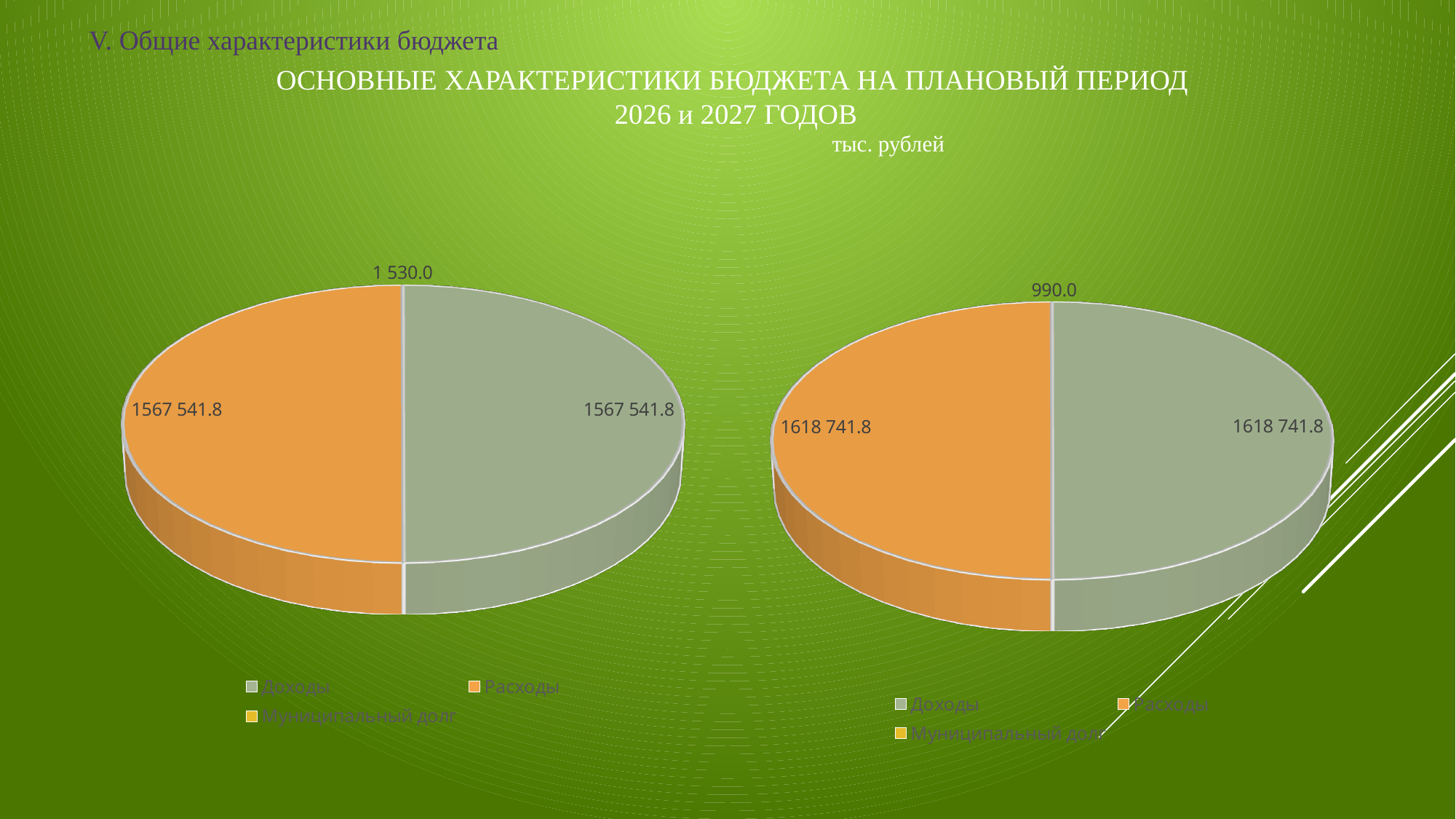
What is the difference between the Муниципальный долг value in the left pie chart (1 530.0) and in the right pie chart (990.0)? 540.0 In the right pie chart, what is the value for Расходы? 1618 741.8 In the right pie chart, which category has the smallest value? Муниципальный долг What kind of chart is the left chart on the slide? pie chart In the left pie chart, what is the value for Муниципальный долг? 1 530.0 In the right pie chart, what is the value for Муниципальный долг? 990.0 In the left pie chart, what is the value for Доходы? 1567 541.8 How many categories are shown in the left pie chart's legend? 3 How many entries does the legend of the right pie chart list? 3 In the right pie chart, what colour is the Доходы slice? grey-green What unit is stated below the slide title for the charts? тыс. рублей In the left pie chart, which is larger: Расходы or Муниципальный долг? Расходы